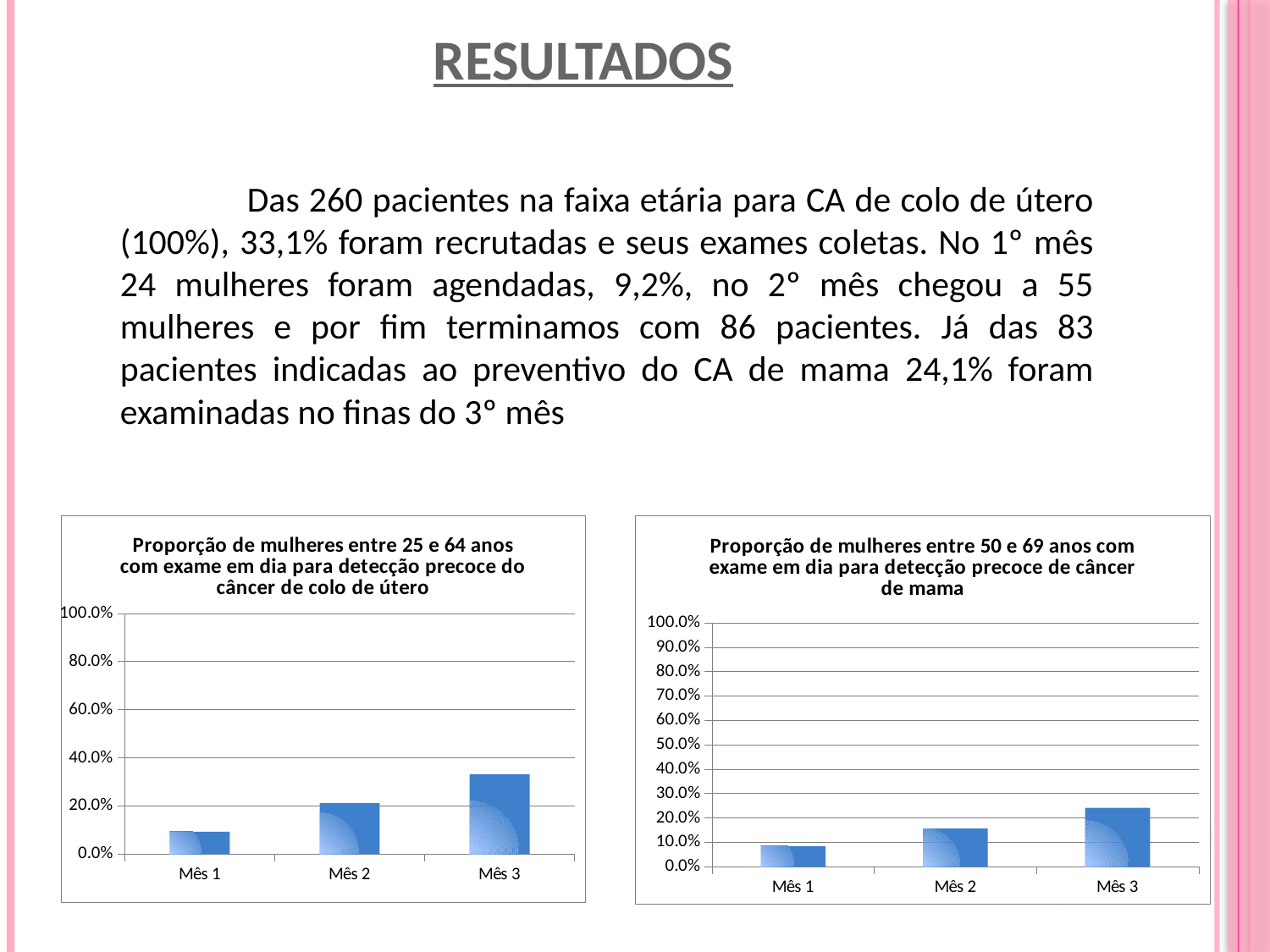
In the right chart (Proporção de mulheres entre 50 e 69 anos), which is larger, the value for Mês 1 or Mês 2? Mês 2 In the left chart (Proporção de mulheres entre 25 e 64 anos), is the value for Mês 3 greater or less than 20.0%? greater What kind of chart is the right chart (Proporção de mulheres entre 50 e 69 anos)? Bar chart In the left chart (Proporção de mulheres entre 25 e 64 anos), do the values rise or fall from Mês 1 to Mês 3? Rise In the right chart (Proporção de mulheres entre 50 e 69 anos), which month has the lowest bar? Mês 1 In the left chart (Proporção de mulheres entre 25 e 64 anos), which month has the highest bar? Mês 3 In the right chart (Proporção de mulheres entre 50 e 69 anos), is the value for Mês 2 greater or less than 20.0%? less In the left chart (Proporção de mulheres entre 25 e 64 anos), which month has the lowest bar? Mês 1 In the right chart (Proporção de mulheres entre 50 e 69 anos), is the value for Mês 3 greater or less than 20.0%? greater How many categories are shown on the x axis of the left chart (Proporção de mulheres entre 25 e 64 anos)? 3 In the right chart (Proporção de mulheres entre 50 e 69 anos), which month has the highest bar? Mês 3